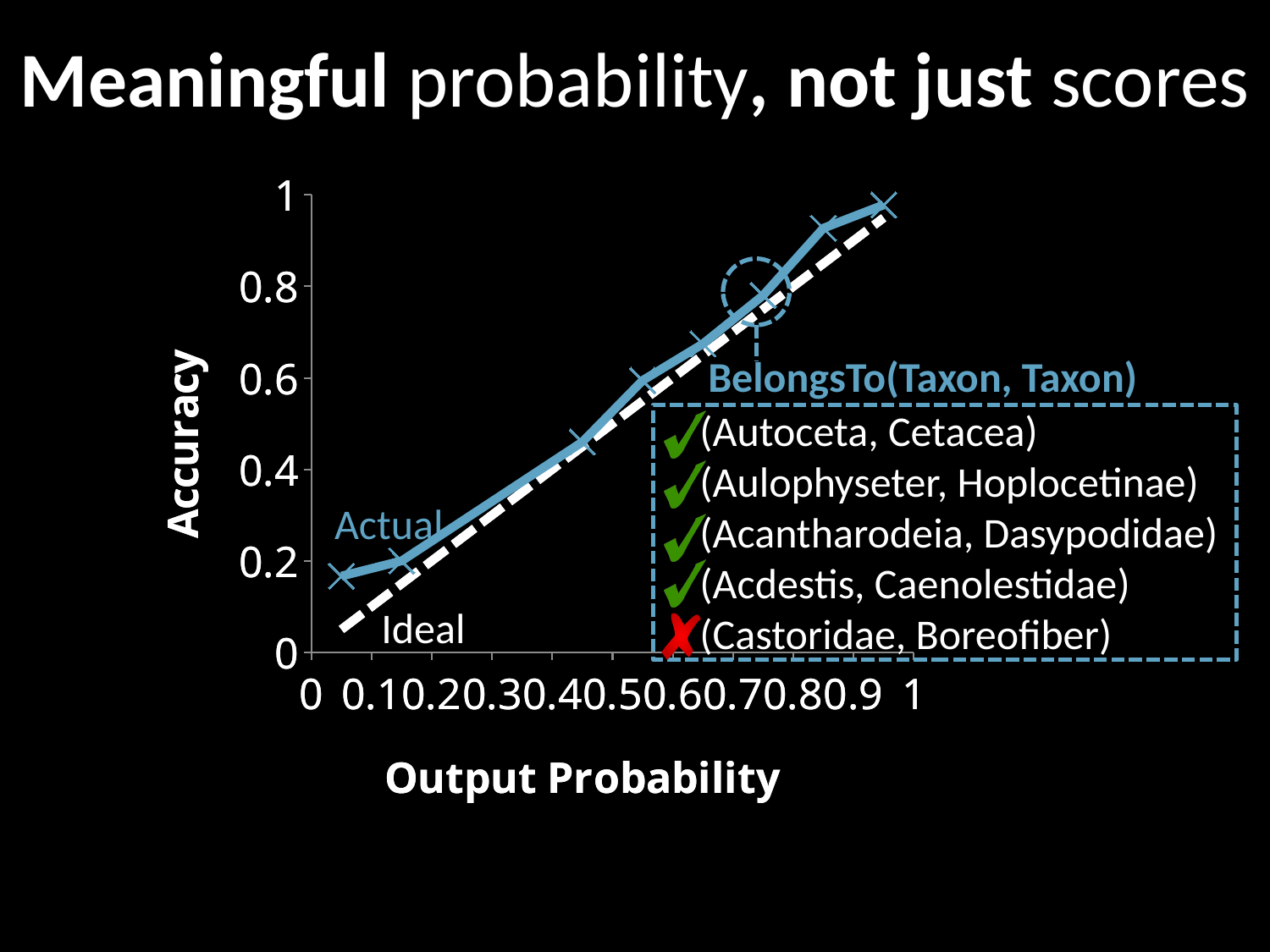
Does the Actual line rise or fall as Output Probability increases? rise Is the Actual accuracy at an output probability of about 0.75 greater or less than 0.6? greater What is the label of the y axis of the chart? Accuracy Does the Actual line reach its highest accuracy at the lowest or the highest output probability? highest Is the Actual accuracy at an output probability of about 0.85 greater or less than 0.8? greater Is the Actual accuracy at an output probability of about 0.45 greater or less than 0.6? less What kind of chart is shown on the slide? line chart At an output probability of about 0.05, which line is higher, Actual or Ideal? Actual What is the label of the x axis of the chart? Output Probability What is the highest value shown on the y axis of the chart? 1